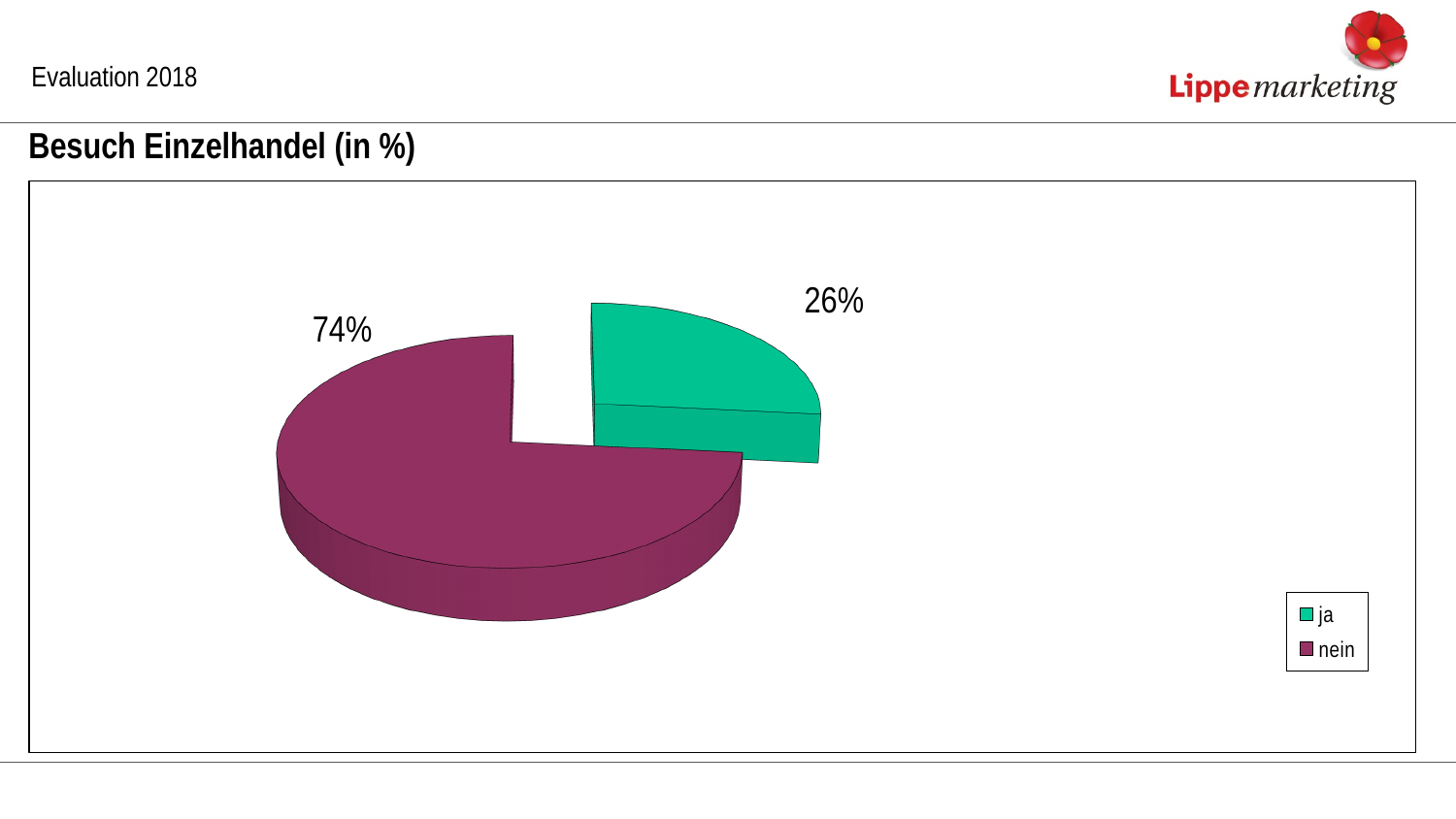
What is the title of the chart? Besuch Einzelhandel (in %) Which is larger, the value for "ja" or the value for "nein"? nein How many entries does the legend list? 2 Which category has the smallest share of the pie? ja What share of the pie does the "ja" slice represent? 26% How many slices does the pie chart have? 2 What is the value for "ja"? 26% What kind of chart is shown on the slide? pie chart What colour is the "nein" slice? purple What is the difference between the values for "nein" and "ja"? 48% What is the value for "nein"? 74% Which category has the largest share of the pie? nein